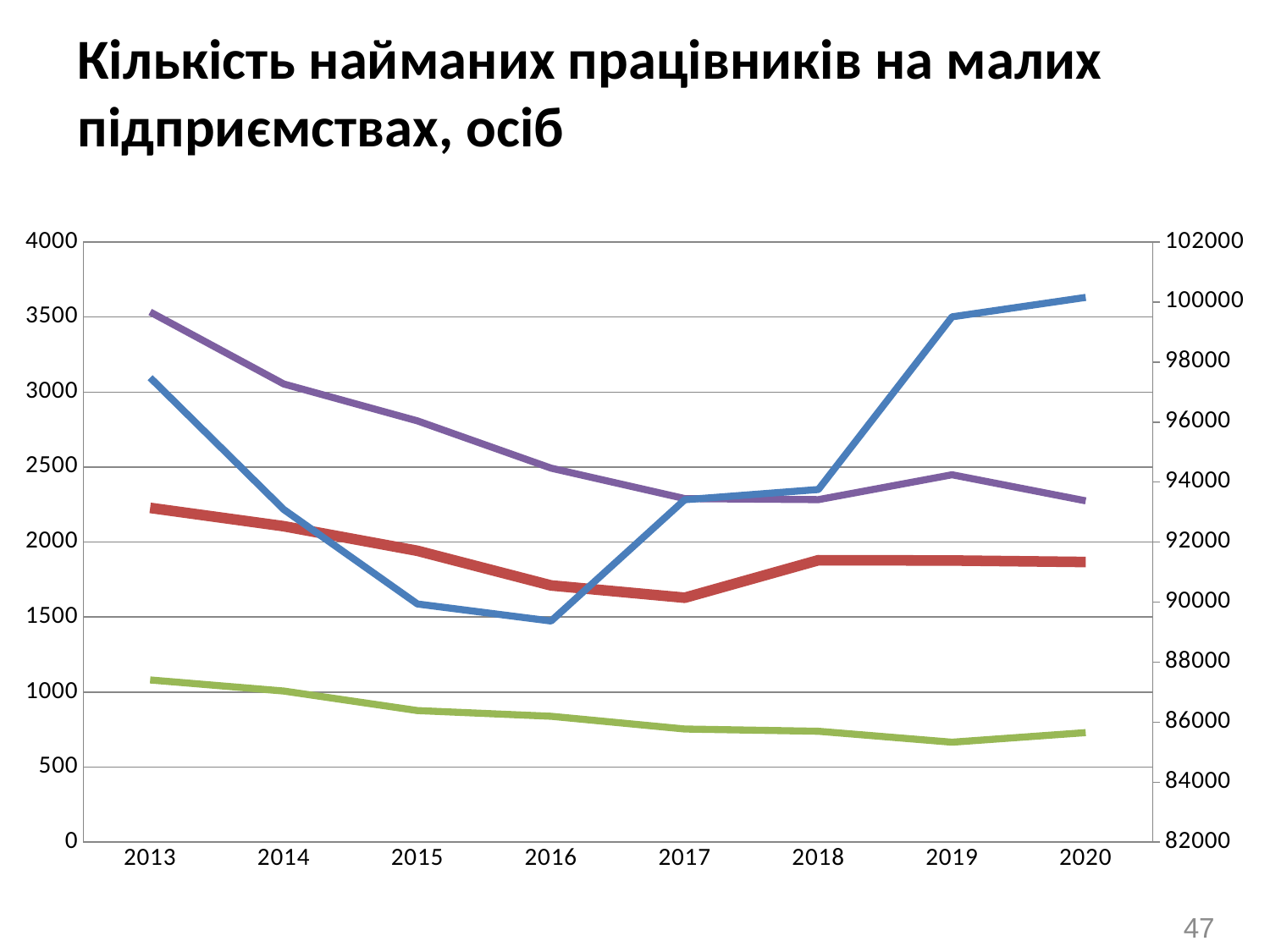
Does the green line overall rise or fall from 2013 to 2020? fall In which year does the red line reach its lowest point? 2017 How many lines are plotted on the chart? 4 In which year does the green line reach its lowest point? 2019 What kind of chart is shown on the slide? line chart In which year does the blue line reach its lowest point? 2016 In which year does the blue line reach its highest point? 2020 Does the purple line overall rise or fall from 2013 to 2020? fall How many years are shown along the x axis of the chart? 8 Is the blue line higher in 2019 or in 2016? 2019 In which year does the purple line reach its highest point? 2013 What is the title of the chart? Кількість найманих працівників на малих підприємствах, осіб